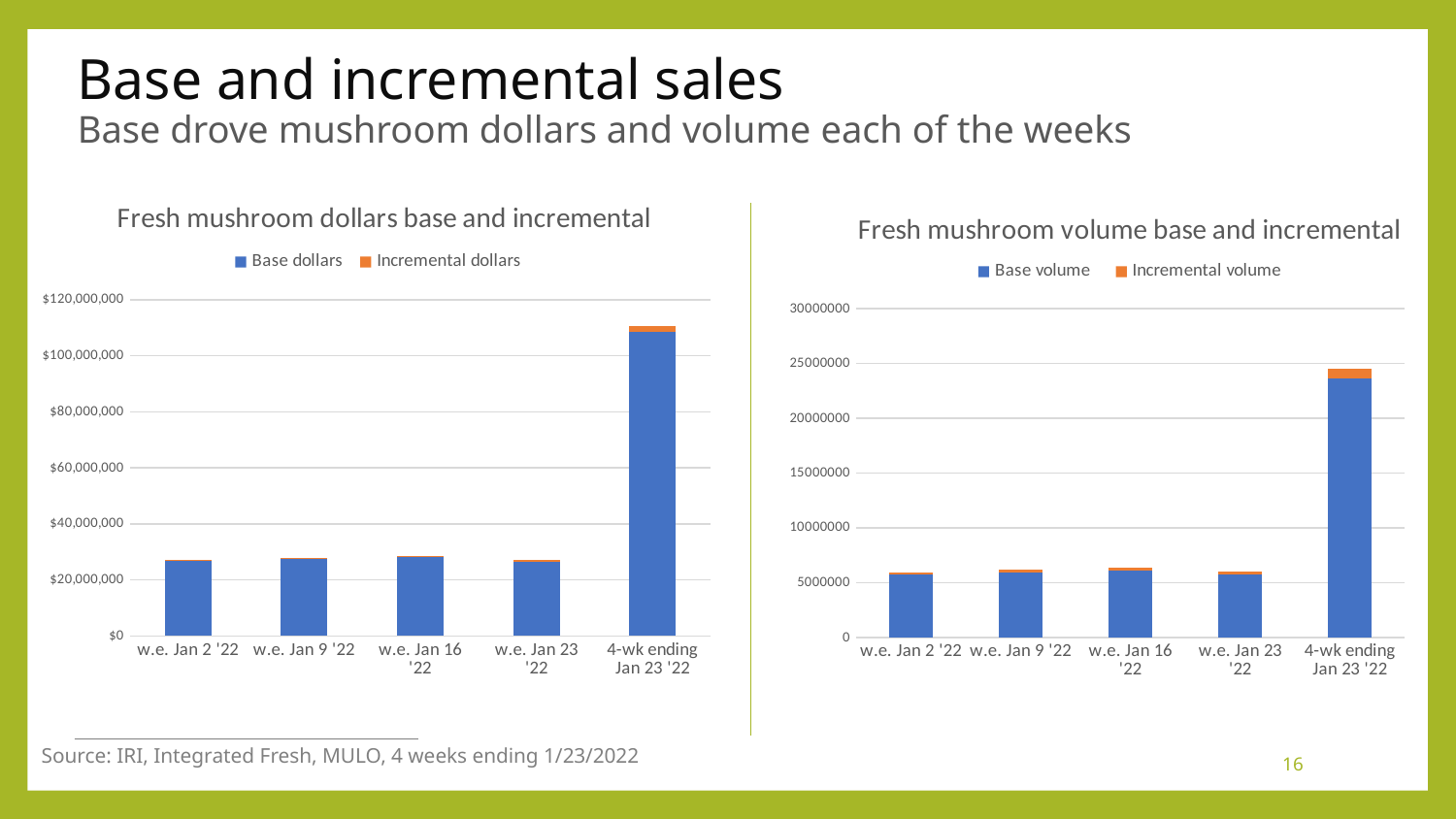
In the 'Fresh mushroom volume base and incremental' chart, is the total bar for w.e. Jan 9 '22 greater or less than 10000000? less How many categories are shown on the x axis of the 'Fresh mushroom dollars base and incremental' chart? 5 What kind of chart is the 'Fresh mushroom dollars base and incremental' chart? Stacked bar chart What are the two legend entries in the 'Fresh mushroom dollars base and incremental' chart? Base dollars and Incremental dollars In the 'Fresh mushroom dollars base and incremental' chart, which category has the tallest bar? 4-wk ending Jan 23 '22 How many series does the legend of the 'Fresh mushroom dollars base and incremental' chart list? 2 In the 'Fresh mushroom dollars base and incremental' chart, is the total bar for w.e. Jan 2 '22 greater or less than $40,000,000? less In the 'Fresh mushroom volume base and incremental' chart, is the total bar for 4-wk ending Jan 23 '22 greater or less than 20000000? greater What kind of chart is the 'Fresh mushroom volume base and incremental' chart? Stacked bar chart In the 'Fresh mushroom volume base and incremental' chart, which category has the tallest bar? 4-wk ending Jan 23 '22 How many series does the legend of the 'Fresh mushroom volume base and incremental' chart list? 2